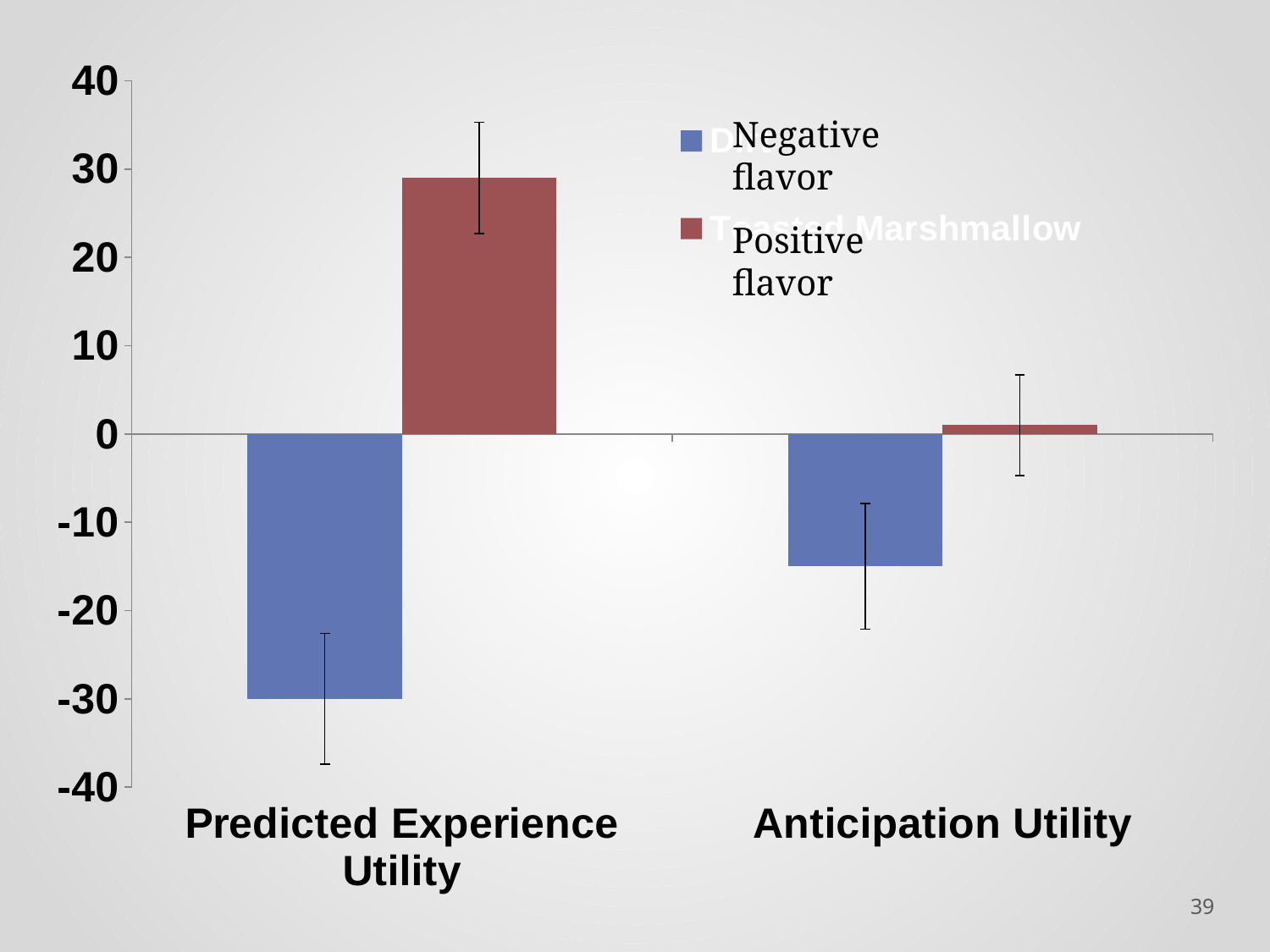
What are the two series named in the chart's legend? Negative flavor and Positive flavor For the Positive flavor series, which category has the larger value: Predicted Experience Utility or Anticipation Utility? Predicted Experience Utility Is the Positive flavor value for Predicted Experience Utility greater or less than 20? greater Which bar in the chart has the lowest value? Negative flavor, Predicted Experience Utility What kind of chart is shown on the slide? bar chart Is the Negative flavor value for Anticipation Utility greater or less than -10? less Is the Negative flavor value for Predicted Experience Utility greater or less than -20? less How many categories are shown on the x axis of the chart? 2 How many series does the chart's legend list? 2 Which bar in the chart has the highest value? Positive flavor, Predicted Experience Utility For the Negative flavor series, which category has the larger value: Predicted Experience Utility or Anticipation Utility? Anticipation Utility